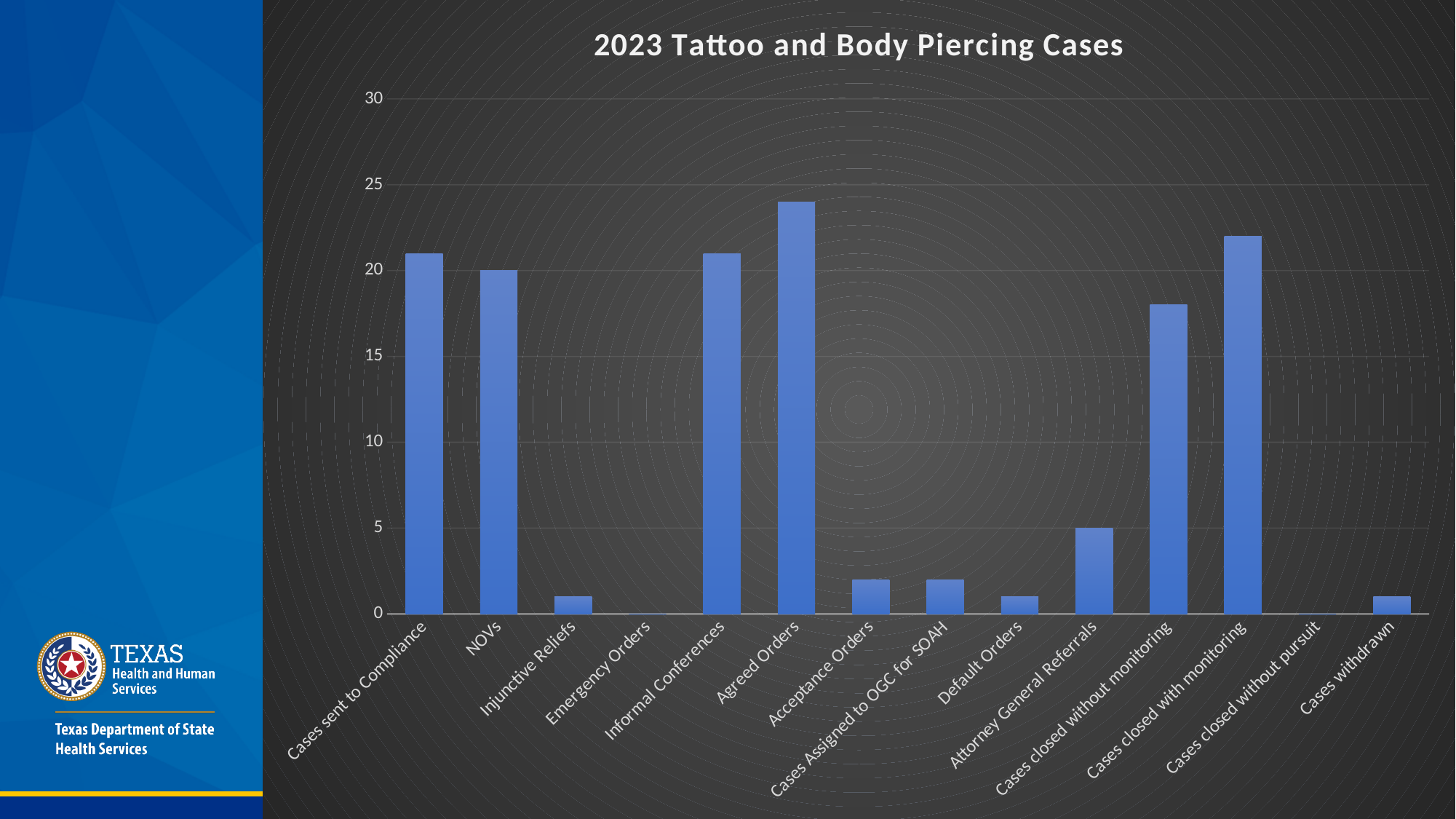
What is the value for Attorney General Referrals? 5 Is the value for Acceptance Orders greater or less than 5? less Is the value for Cases closed without monitoring greater or less than 20? less Is the value for Agreed Orders greater or less than 25? less How many categories are shown on the x axis of the chart? 14 What kind of chart is shown on the slide? bar chart What is the title of the chart? 2023 Tattoo and Body Piercing Cases Which is larger, the value for Cases closed with monitoring or the value for Cases closed without monitoring? Cases closed with monitoring Which category has the highest value in the chart? Agreed Orders Which is larger, the value for Agreed Orders or the value for NOVs? Agreed Orders What is the value for NOVs? 20